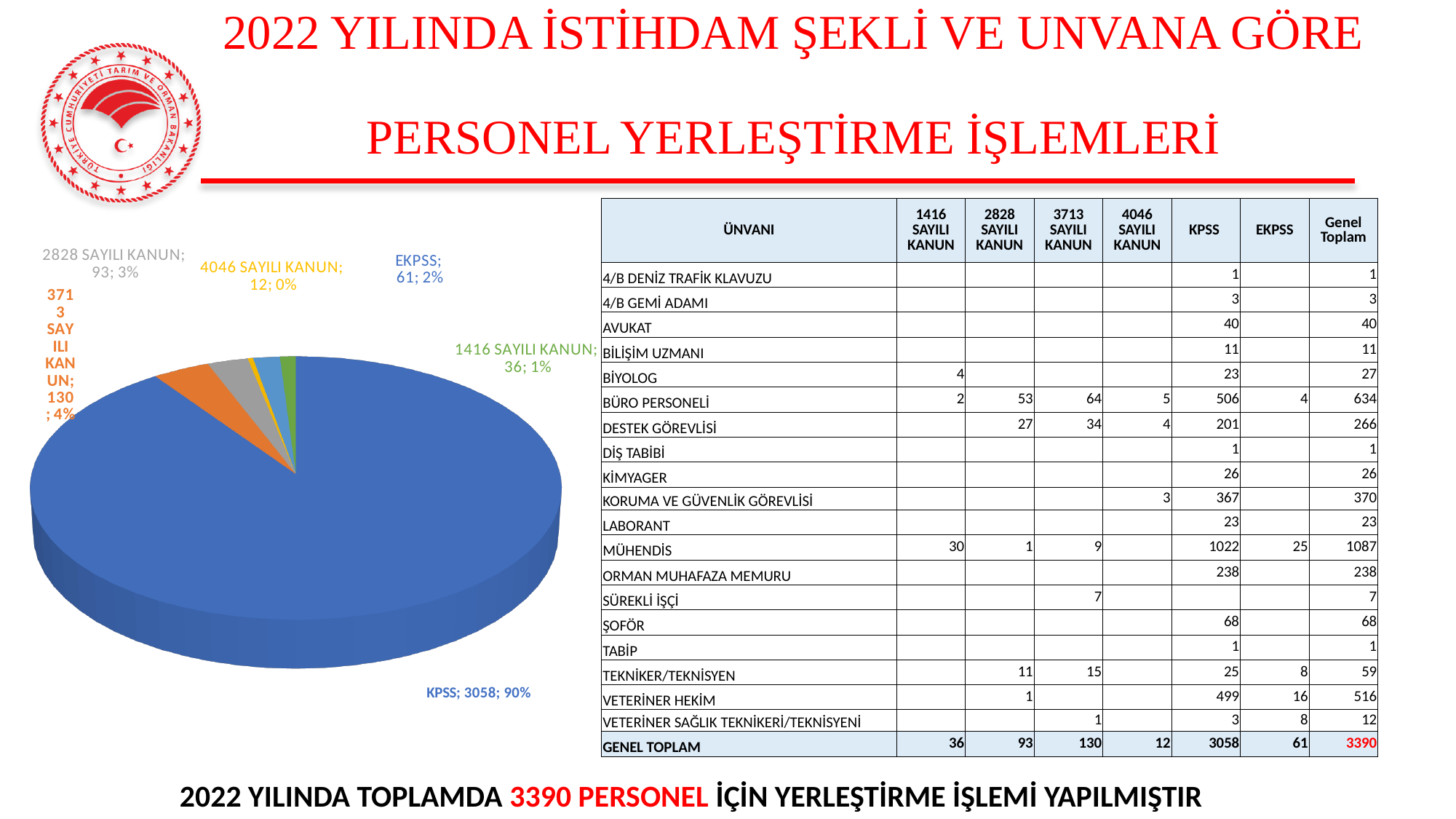
Which category has the largest slice in the pie chart? KPSS What colour is the KPSS slice in the pie chart? blue What is the value shown for KPSS in the pie chart? 3058 What kind of chart is shown on the slide? pie chart Which is larger in the pie chart, the value for 3713 SAYILI KANUN or the value for EKPSS? 3713 SAYILI KANUN How many slices does the pie chart have? 6 What percentage share does KPSS have in the pie chart? 90% What is the value shown for EKPSS in the pie chart? 61 What percentage share does 2828 SAYILI KANUN have in the pie chart? 3% What is the value shown for 3713 SAYILI KANUN in the pie chart? 130 Which category has the smallest slice in the pie chart? 4046 SAYILI KANUN What is the difference between the values for 2828 SAYILI KANUN and 1416 SAYILI KANUN in the pie chart? 57